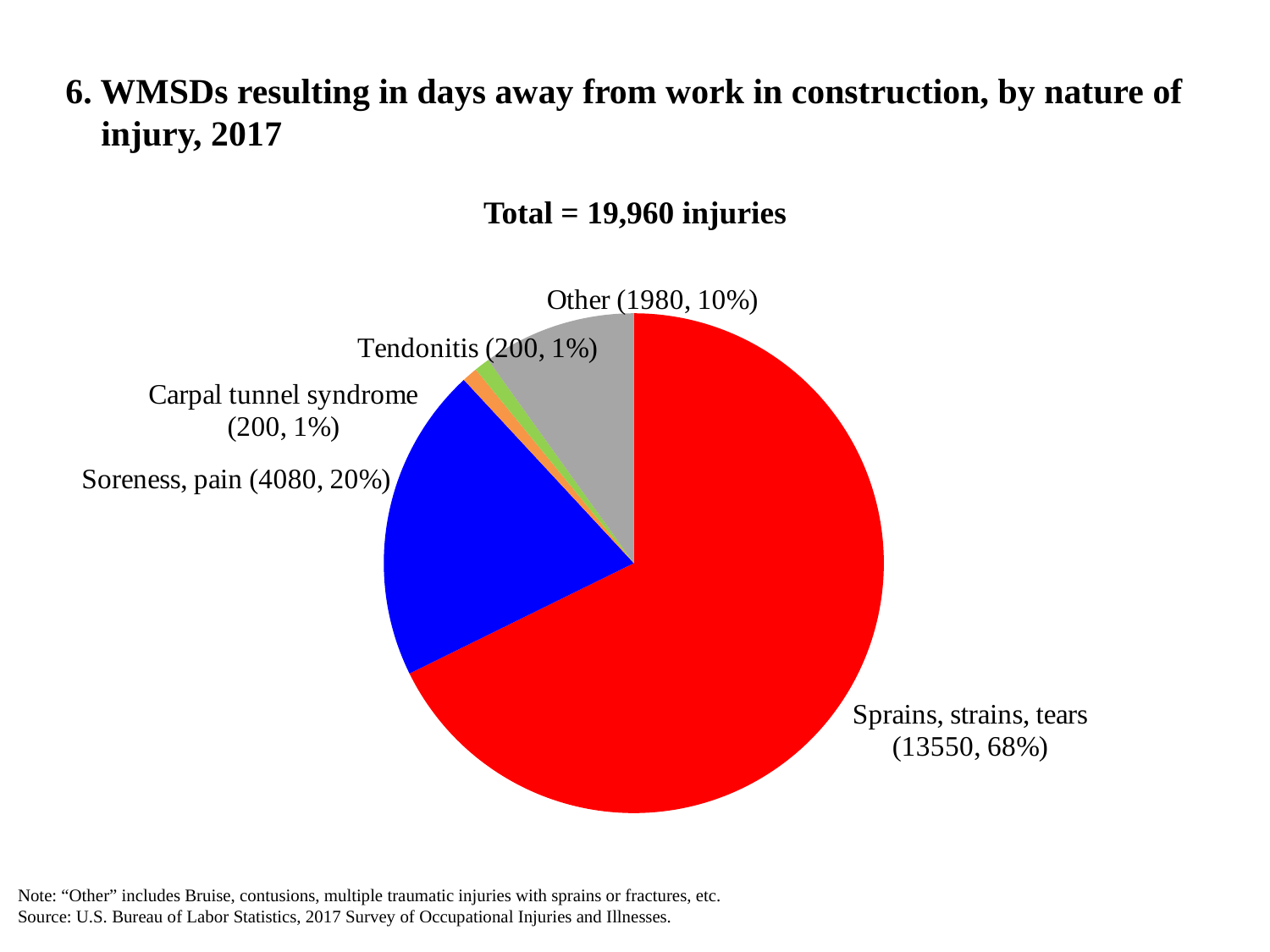
How many injuries are in the Other category? 1980 What is the total number of injuries shown on the slide? 19,960 injuries What kind of chart is shown on the slide? pie chart What is the difference in injuries between Sprains, strains, tears and Soreness, pain? 9470 How many injuries are attributed to Sprains, strains, tears? 13550 Which nature of injury accounts for the largest slice of the pie? Sprains, strains, tears What colour is the Sprains, strains, tears slice? red What share of the pie does Soreness, pain represent? 20% Which is larger, the Other slice or the Soreness, pain slice? Soreness, pain What percentage share does Tendonitis have? 1% What year does the chart title refer to? 2017 How many slices does the pie chart have? 5